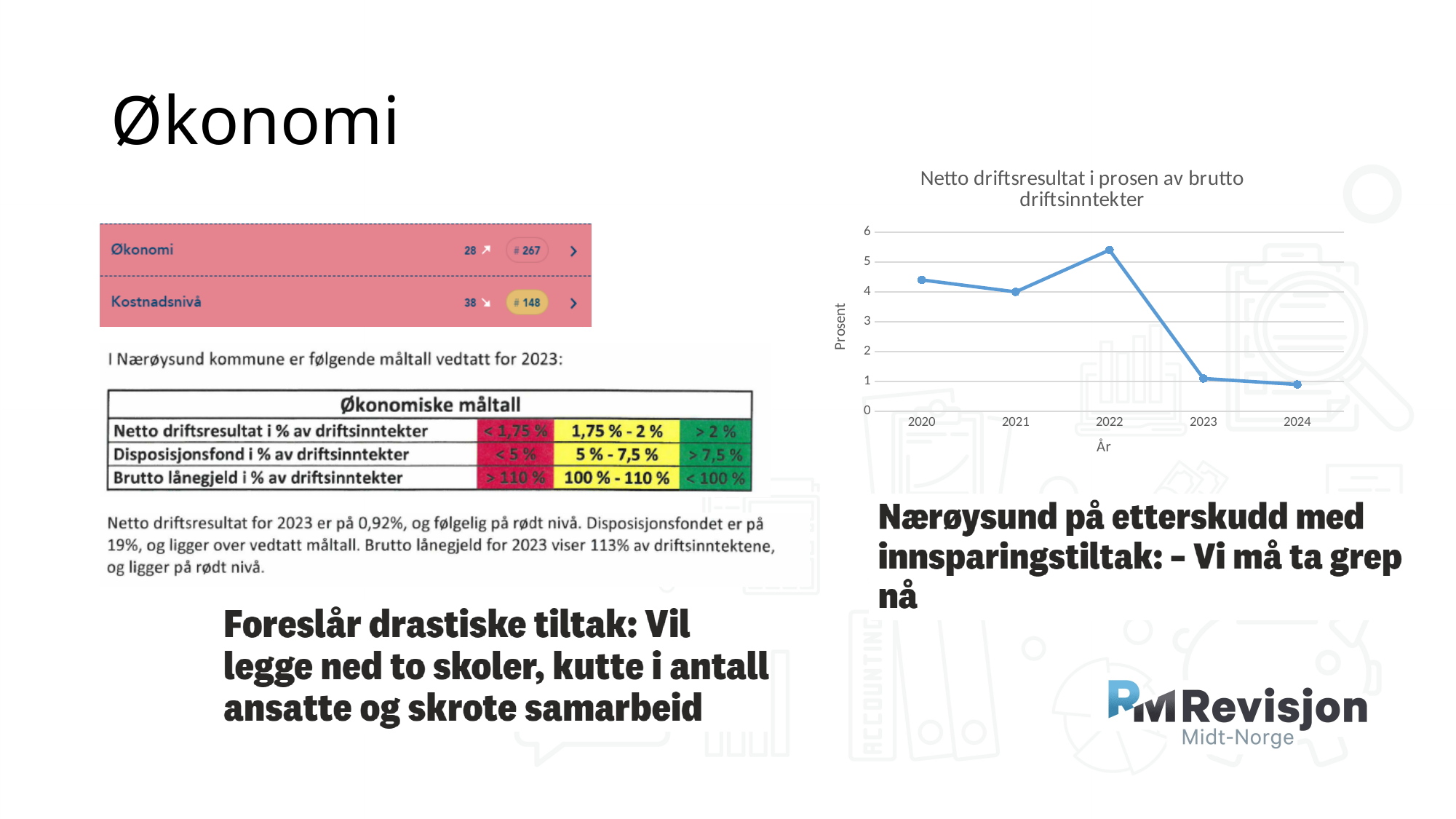
Which year has the lowest value on the chart? 2024 What is the label of the vertical axis of the chart? Prosent Is the value for 2023 greater or less than 2? less Do the values rise or fall from 2022 to 2024? fall Is the value for 2022 greater or less than 5? greater What is the title of the chart on the slide? Netto driftsresultat i prosen av brutto driftsinntekter How many years are plotted on the chart? 5 Which year has the higher value, 2020 or 2021? 2020 Is the value for 2021 greater or less than 5? less Which year has the highest value on the chart? 2022 What kind of chart is shown on the slide? line chart